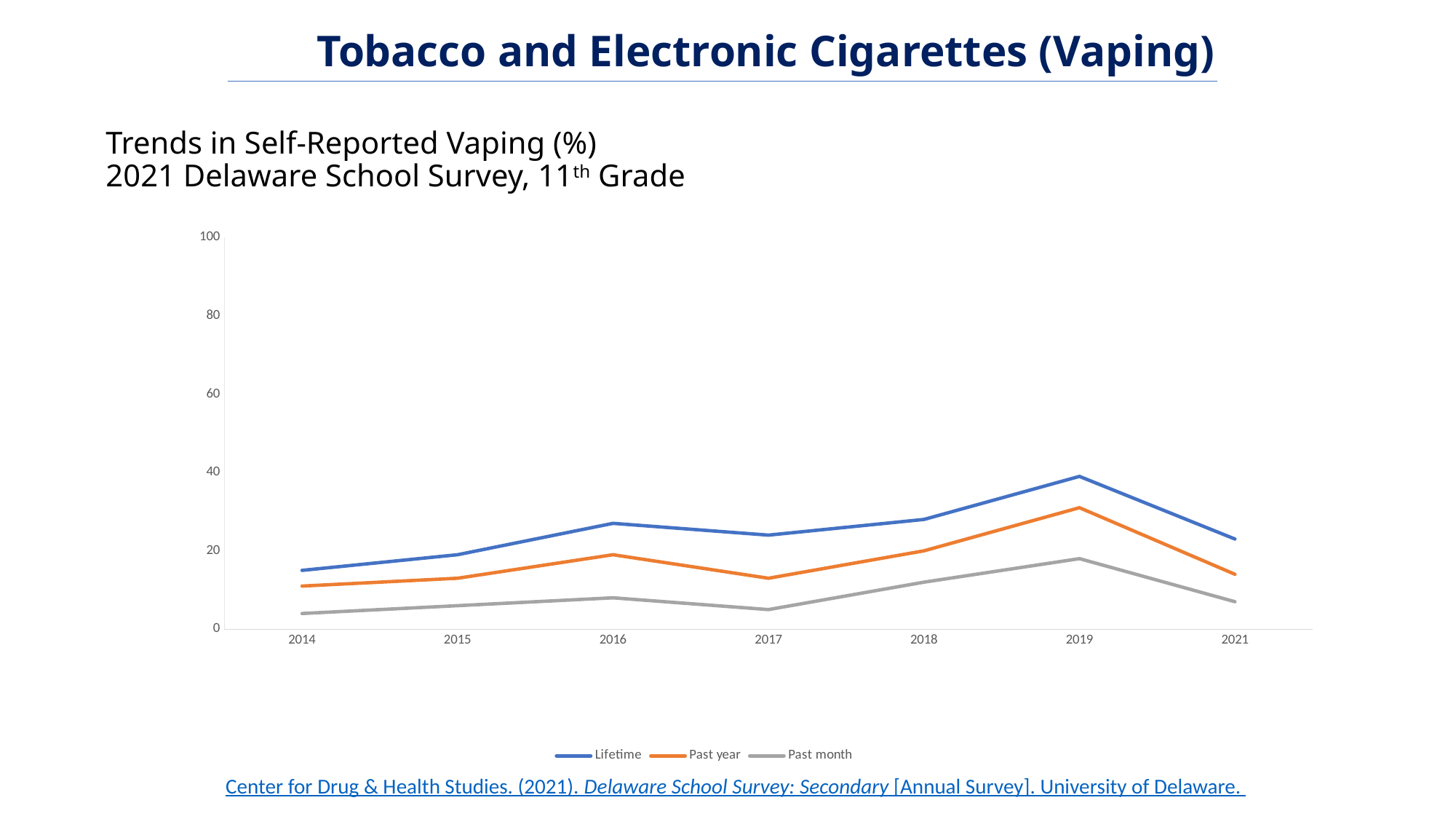
Is the Lifetime value for 2019 greater or less than 20? greater Is the Lifetime value for 2014 greater or less than 20? less Is the Past year value for 2019 greater or less than 20? greater Which series is drawn in orange? Past year How many years are plotted along the x axis? 7 What kind of chart is shown on the slide? line chart How many series does the legend list? 3 Do the values for all three series rise or fall from 2019 to 2021? fall In which year does the Past month series reach its highest value? 2019 Which series has the larger value in 2019, Lifetime or Past month? Lifetime In which year is the Lifetime series at its lowest value? 2014 In which year does the Lifetime series reach its highest value? 2019